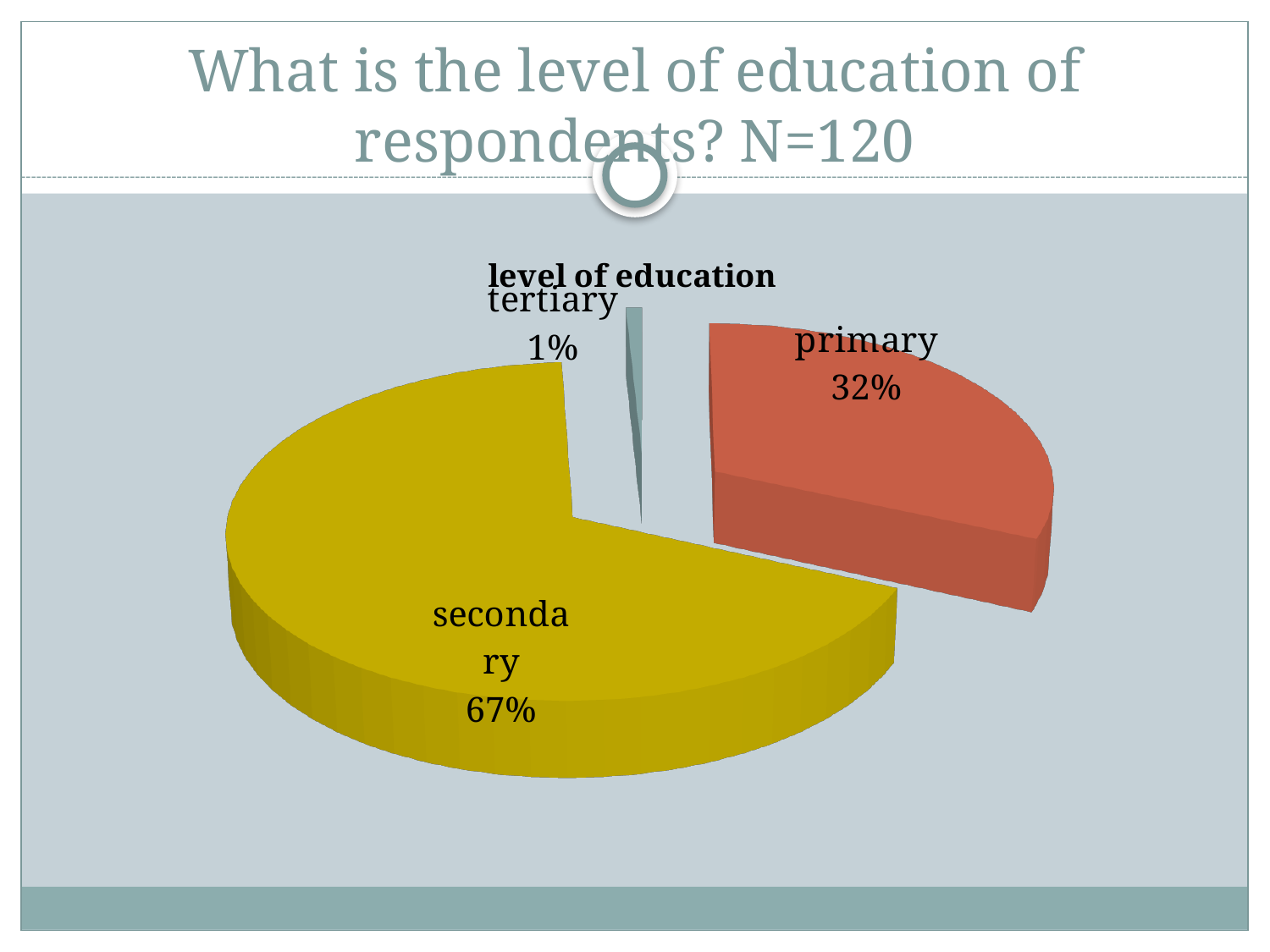
Which level of education has the smallest share of respondents? tertiary What share of respondents have primary education? 32% What is the difference in percentage points between the primary and tertiary shares? 31 What kind of chart is shown on the slide? pie chart What is the title of the chart? level of education What share of respondents have tertiary education? 1% Which is larger, the share for primary or the share for tertiary? primary How many education levels are shown in the pie chart? 3 What share of respondents have secondary education? 67% Which level of education has the largest share of respondents? secondary What colour is the slice for secondary education? yellow What is the difference in percentage points between the secondary and primary shares? 35